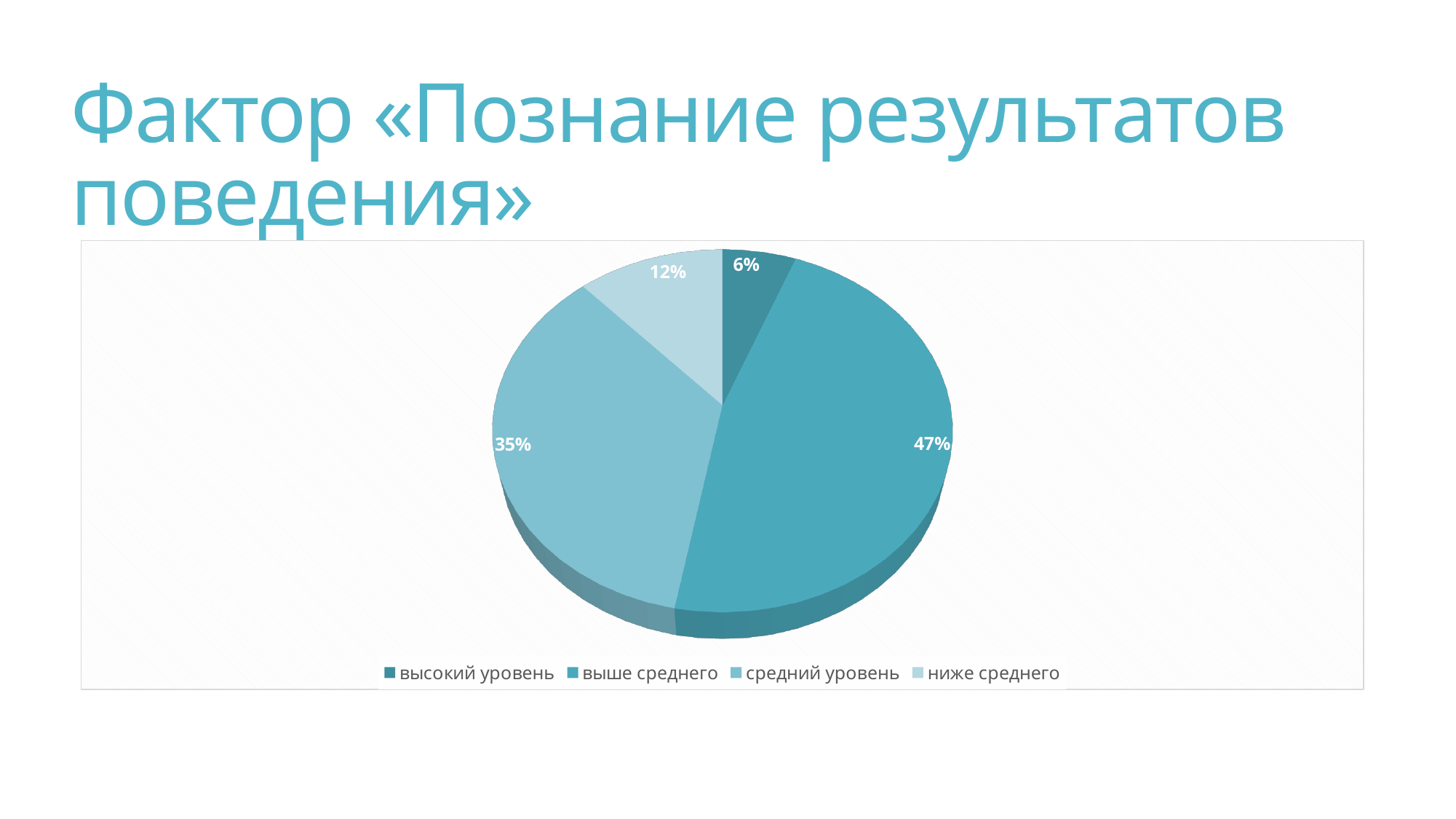
What is the difference in percentage points between «выше среднего» and «средний уровень»? 12 Which category has the largest share of the pie? выше среднего What percentage of the pie is labelled «средний уровень»? 35% How many slices does the pie chart have? 4 What percentage of the pie is labelled «высокий уровень»? 6% Which is larger: the share for «средний уровень» or the share for «ниже среднего»? средний уровень What is the title of the slide containing the chart? Фактор «Познание результатов поведения» Which category has the smallest share of the pie? высокий уровень What percentage of the pie is labelled «ниже среднего»? 12% What is the difference in percentage points between «ниже среднего» and «высокий уровень»? 6 What kind of chart is shown on the slide? pie chart What percentage of the pie is labelled «выше среднего»? 47%